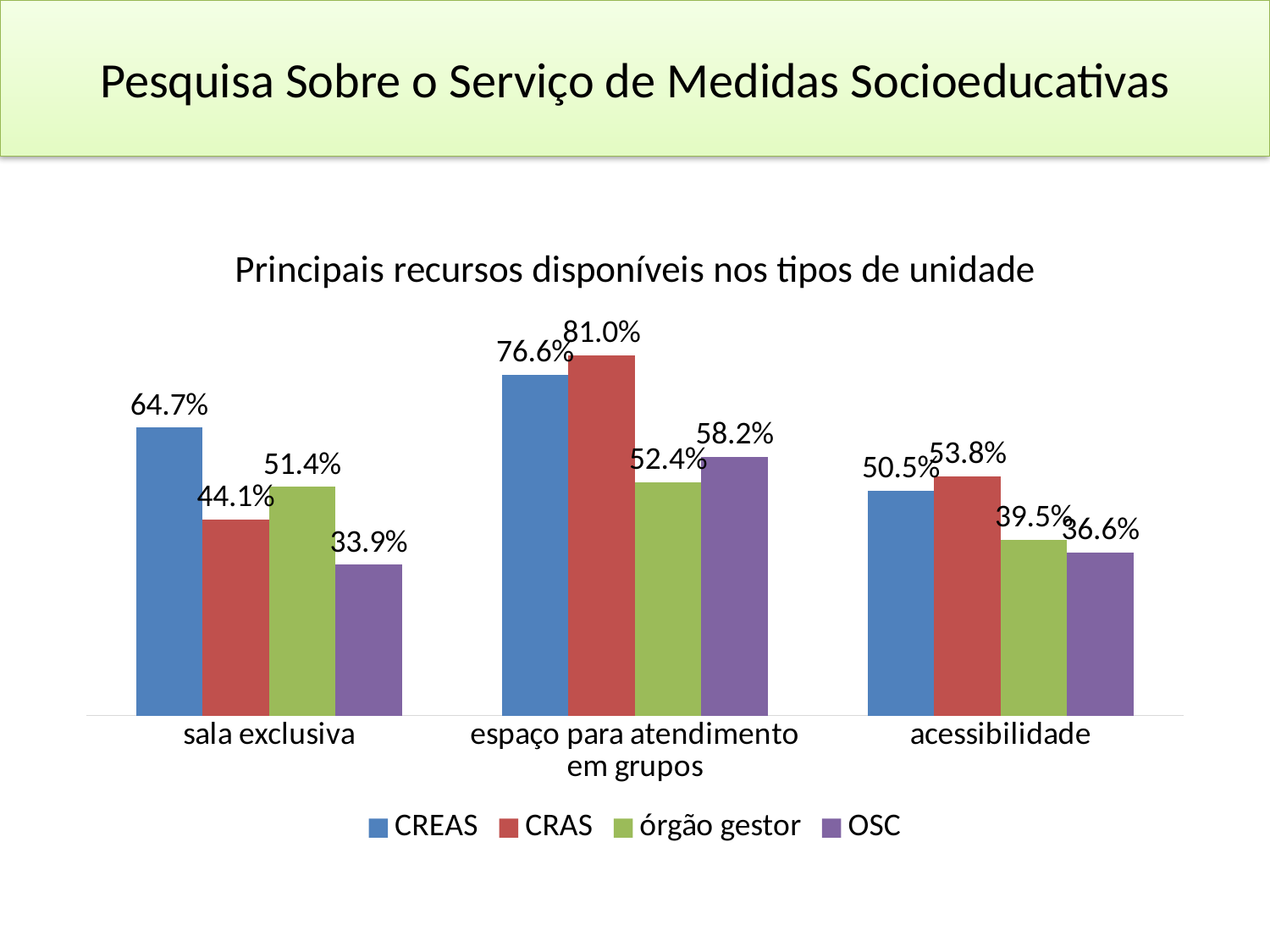
Which is larger in the 'sala exclusiva' category: the CRAS value or the órgão gestor value? órgão gestor What is the value for órgão gestor in the 'sala exclusiva' category? 51.4% How many series does the legend list? 4 What is the value for OSC in the 'acessibilidade' category? 36.6% What is the value for CREAS in the 'sala exclusiva' category? 64.7% Which series has the lowest value in the 'sala exclusiva' category? OSC What is the difference between the CRAS and CREAS values in the 'acessibilidade' category? 3.3% What kind of chart is shown on the slide? bar chart What is the title of the chart? Principais recursos disponíveis nos tipos de unidade What is the value for CRAS in the 'espaço para atendimento em grupos' category? 81.0% How many categories are shown on the x axis? 3 Which series has the highest value in the 'espaço para atendimento em grupos' category? CRAS